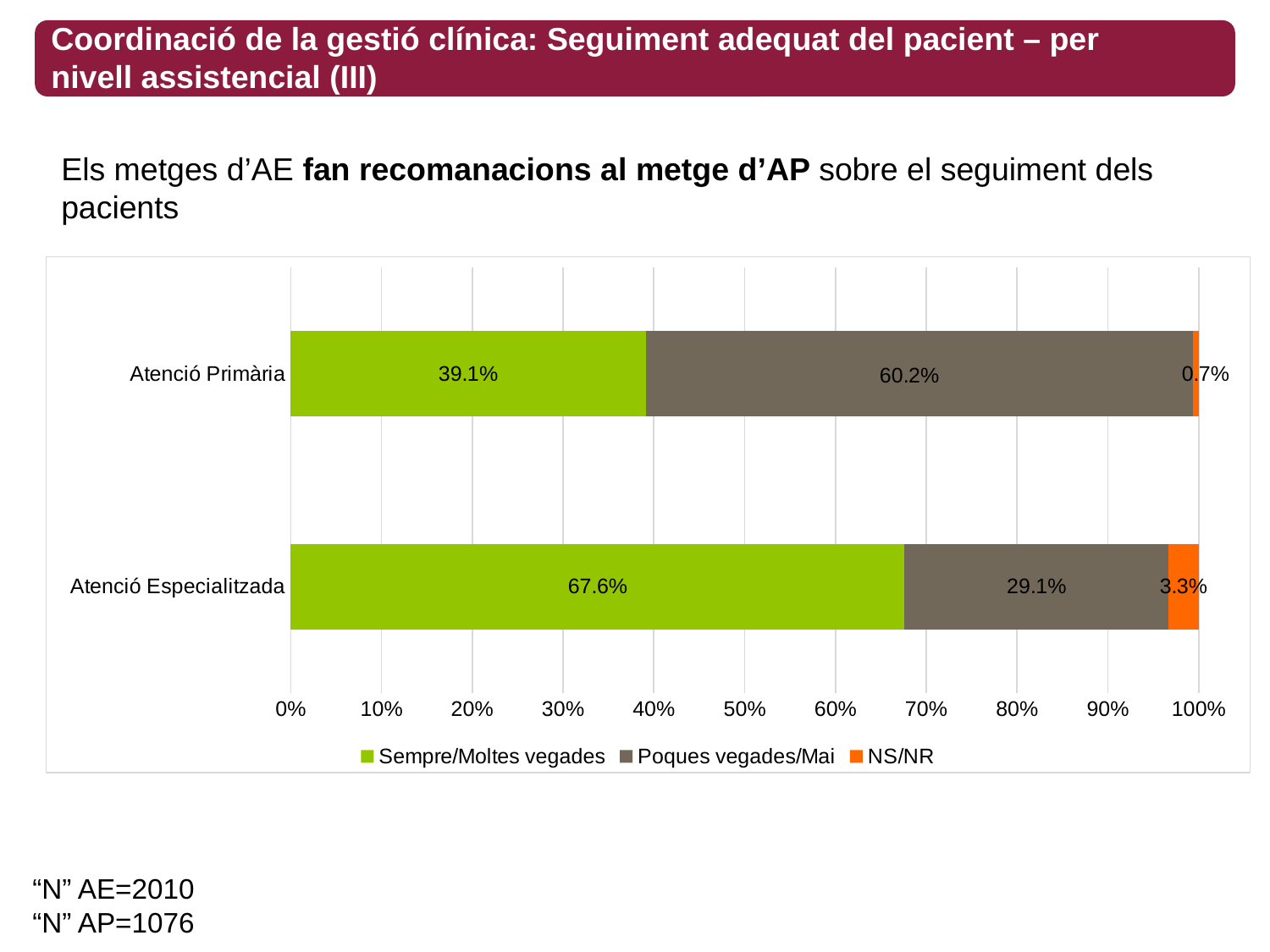
What is the NS/NR value for Atenció Primària? 0.7% Which category has the lower NS/NR value? Atenció Primària What is the value for Sempre/Moltes vegades for Atenció Primària? 39.1% Which category has the higher value for Poques vegades/Mai? Atenció Primària What kind of chart is shown? Stacked bar chart Is the Sempre/Moltes vegades value for Atenció Primària larger or smaller than the Poques vegades/Mai value for Atenció Primària? smaller What is the total of the stacked bar for Atenció Especialitzada? 100% What is the value for Sempre/Moltes vegades for Atenció Especialitzada? 67.6% How many series does the legend list? 3 How many categories are shown on the vertical axis? 2 What is the value for Poques vegades/Mai for Atenció Especialitzada? 29.1% What is the difference between the Sempre/Moltes vegades values for Atenció Especialitzada and Atenció Primària? 28.5%